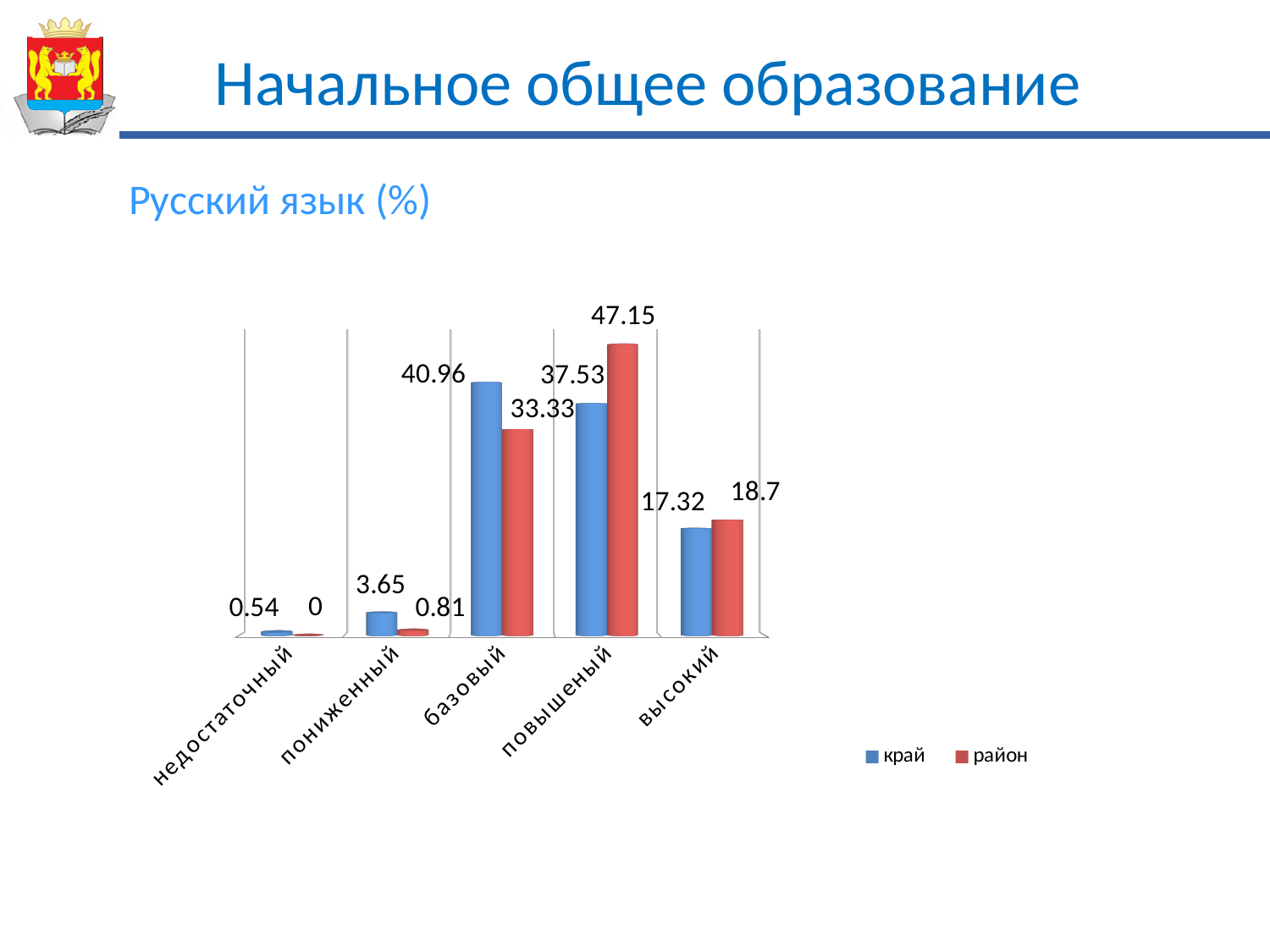
What is the value for район in the недостаточный category? 0 What is the value for край in the высокий category? 17.32 What is the value for район in the повышеный category? 47.15 Which is larger in the базовый category, край or район? край How many series does the legend list? 2 How many categories are shown on the x axis? 5 What is the difference between район and край in the повышеный category? 9.62 Which category has the lowest value for the край series? недостаточный What is the value for край in the базовый category? 40.96 Which category has the highest value for the район series? повышеный Which colour represents the район series? red What kind of chart is shown on the slide? bar chart